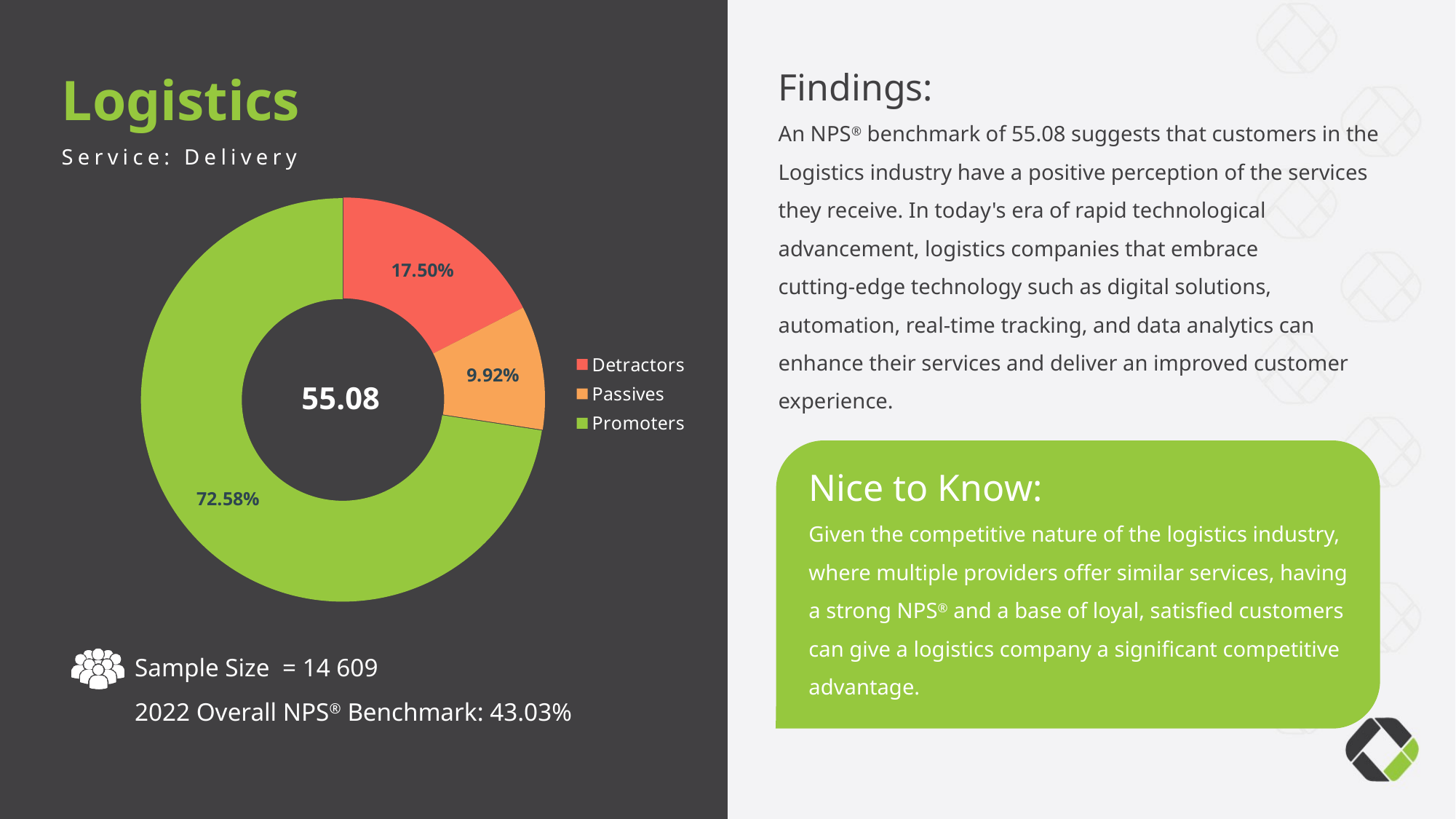
What percentage of the chart is Passives? 9.92% What percentage of the chart is Detractors? 17.50% What colour represents Passives in the chart? Orange What percentage of the chart is Promoters? 72.58% How many categories does the legend list? 3 Which is larger, the Detractors share or the Passives share? Detractors What number is displayed in the centre of the doughnut chart? 55.08 Which category has the largest share of the chart? Promoters What kind of chart is shown on the slide? Doughnut (pie) chart Which category has the smallest share of the chart? Passives What is the difference in percentage points between the Promoters share and the Detractors share? 55.08 What is the difference in percentage points between the Detractors share and the Passives share? 7.58